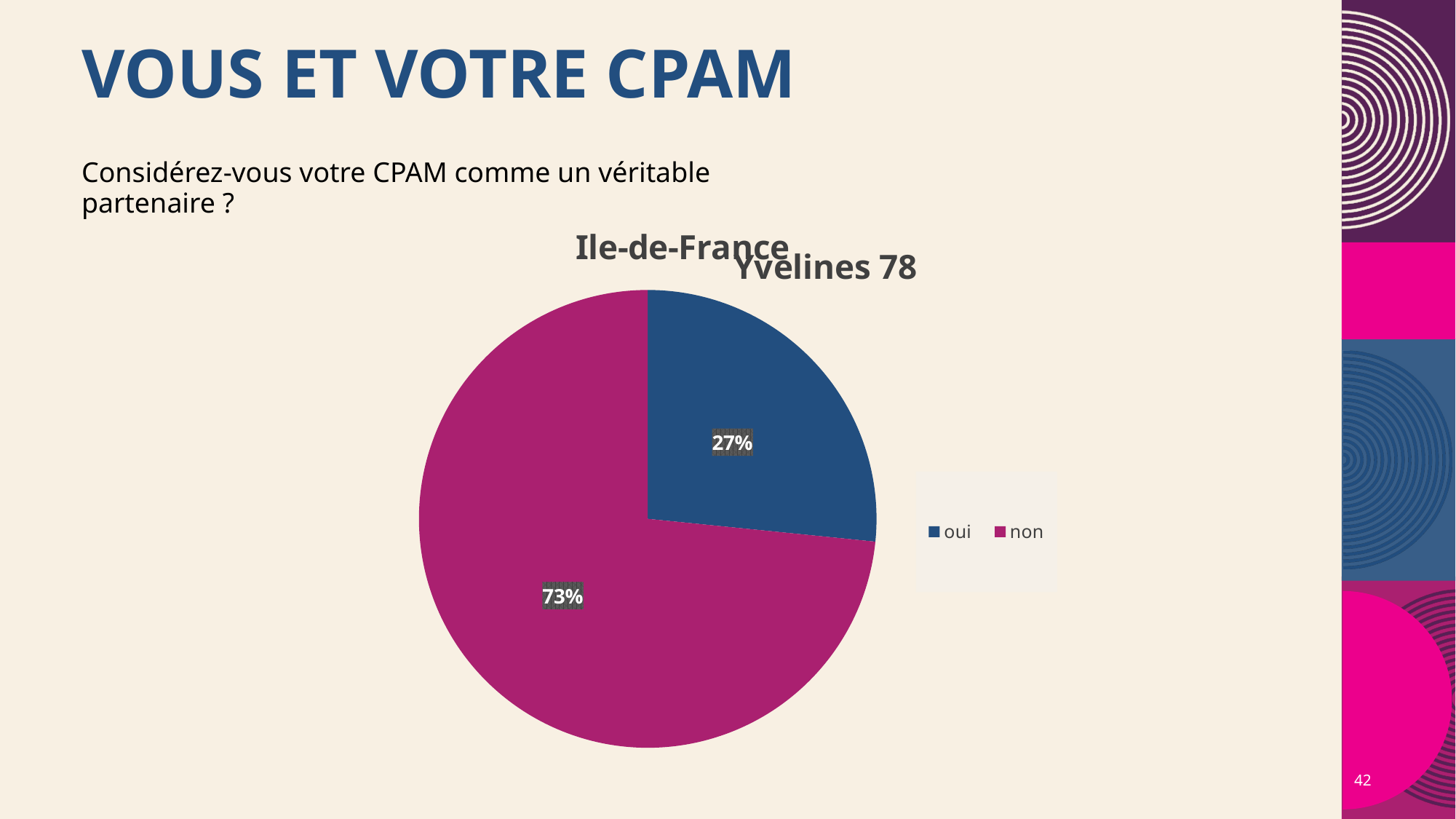
What percentage of respondents answered "non"? 73% Which colour represents "oui" in the pie chart? blue Which is larger, the share for "oui" or the share for "non"? non What share of the pie does the "non" slice represent? 73% How many entries does the legend list? 2 What percentage of respondents answered "oui"? 27% What is the difference in percentage points between "non" and "oui"? 46 Which answer has the largest share of the pie? non What type of chart is shown on the slide? pie chart What question is the pie chart answering, according to the text on the slide? Considérez-vous votre CPAM comme un véritable partenaire ? How many slices does the pie chart have? 2 Which answer has the smallest share of the pie? oui